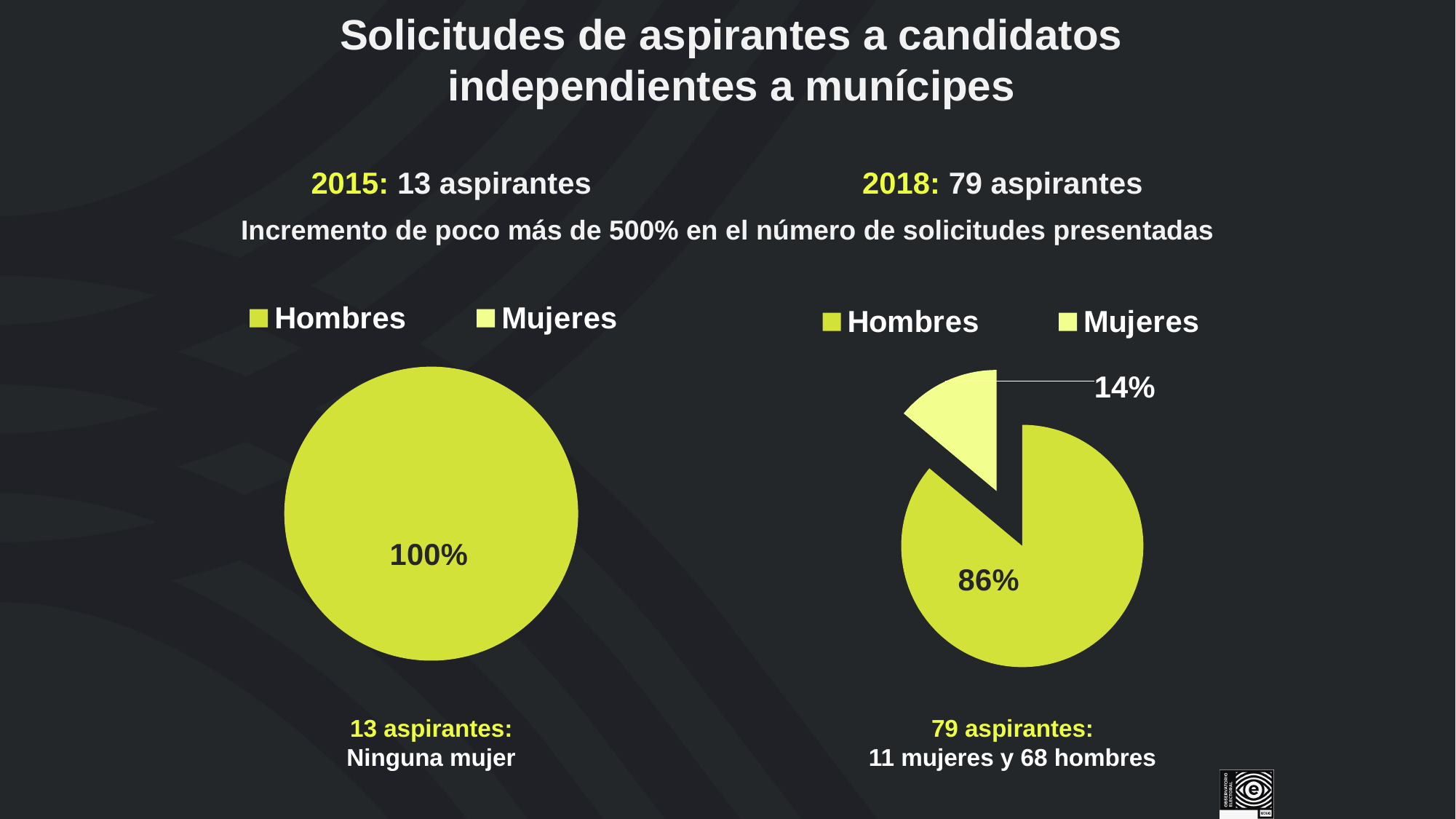
How many series does the legend of the left pie chart list? 2 Which pie chart shows a slice for Mujeres, the left (2015) or the right (2018)? The right (2018) In the right pie chart (2018), which category has the largest slice? Hombres In the right pie chart (2018), which category has the smallest slice? Mujeres What kind of chart is shown on the left side of the slide? Pie chart In the right pie chart (2018), is the Hombres slice larger or smaller than the Mujeres slice? Larger In the right pie chart (2018), what share is labelled for Mujeres? 14% In the left pie chart (2015), what share is labelled for Hombres? 100% What are the two legend entries shown above the right pie chart? Hombres and Mujeres In the right pie chart (2018), what share is labelled for Hombres? 86% In the right pie chart (2018), what is the difference in percentage points between the Hombres and Mujeres slices? 72 How many slices are visible in the right pie chart (2018)? 2